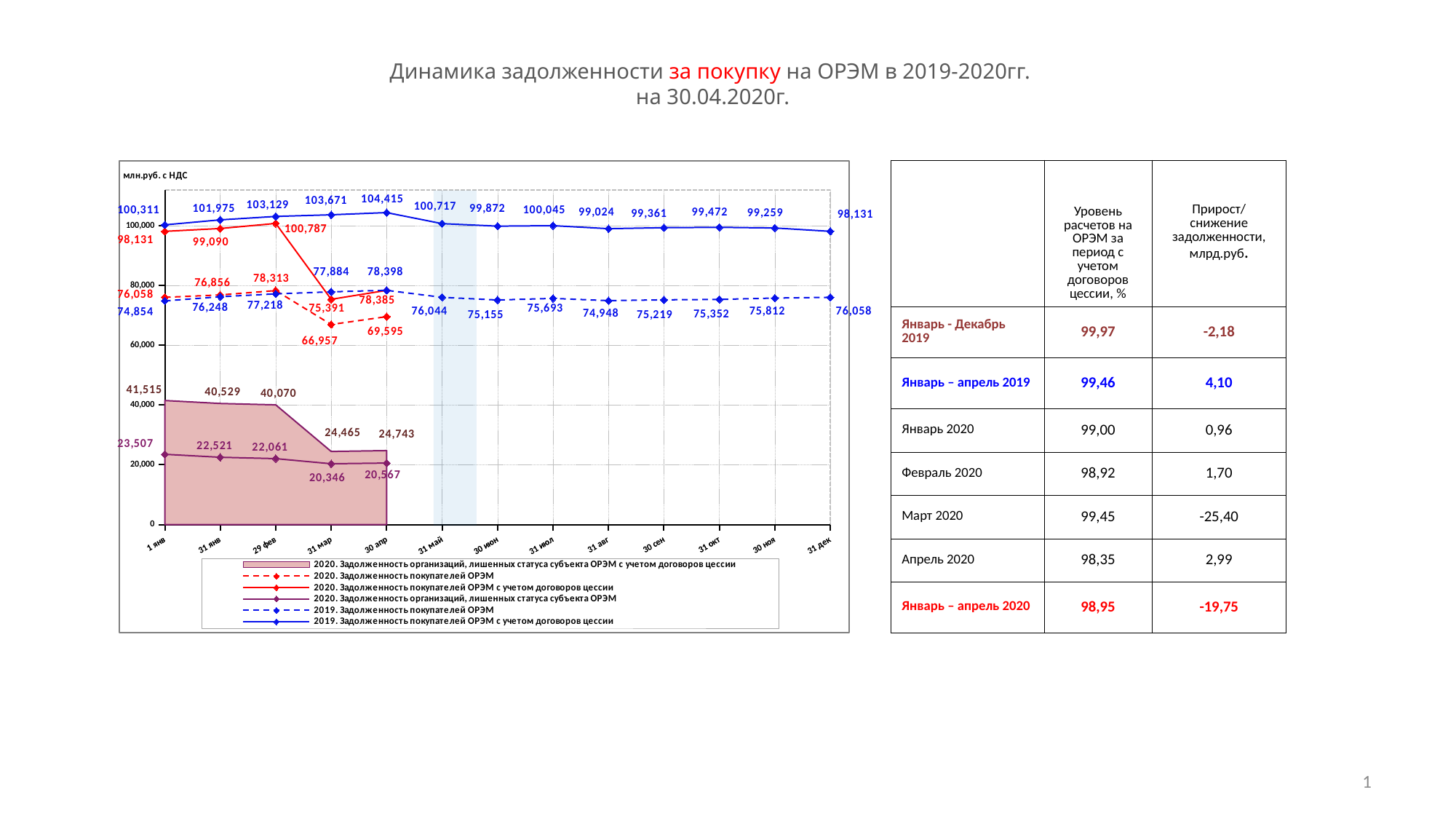
At which date does the series "2019. Задолженность покупателей ОРЭМ с учетом договоров цессии" reach its highest value? 30 апр What is the value of the series "2019. Задолженность покупателей ОРЭМ с учетом договоров цессии" at 30 апр? 104,415 What is the value of the series "2019. Задолженность покупателей ОРЭМ" at 31 дек? 76,058 At which date does the series "2019. Задолженность покупателей ОРЭМ" have its lowest value? 1 янв Which is larger at 29 фев: the 2020 value with cession agreements (red solid line) or the 2019 value with cession agreements (blue solid line)? 2019 (103,129) How many dates are marked along the x axis of the chart? 13 What is the value of the series "2020. Задолженность организаций, лишенных статуса субъекта ОРЭМ" at 31 мар? 20,346 What kind of chart is shown on the slide? combination area and line chart How many series does the chart legend list? 6 What is the difference between the 1 янв and 31 дек values of the series "2019. Задолженность покупателей ОРЭМ с учетом договоров цессии"? 2,180 What is the value of the series "2020. Задолженность организаций, лишенных статуса субъекта ОРЭМ с учетом договоров цессии" at 1 янв? 41,515 Does the series "2020. Задолженность организаций, лишенных статуса субъекта ОРЭМ с учетом договоров цессии" rise or fall from 1 янв to 30 апр? fall